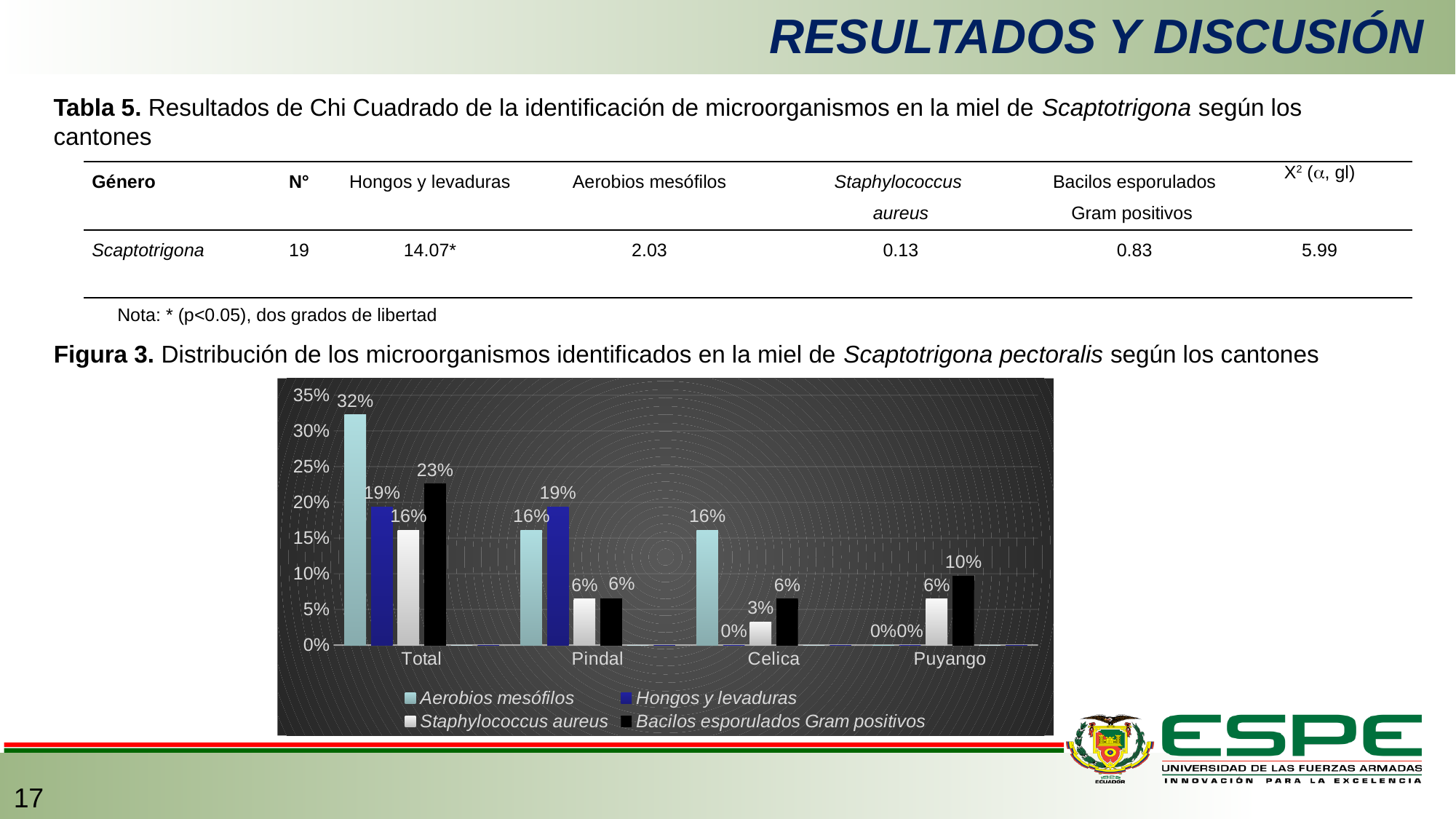
In Figura 3, which series has the highest value in the Total category? Aerobios mesófilos In Figura 3, what is the value for Hongos y levaduras in Pindal? 19% In Figura 3, which series has the lowest value in Celica? Hongos y levaduras In Figura 3, what is the value for Aerobios mesófilos in the Total category? 32% In Figura 3, how many cantón categories are shown on the x axis? 4 In Figura 3, which is larger in Pindal: Aerobios mesófilos or Hongos y levaduras? Hongos y levaduras In Figura 3, what is the value for Bacilos esporulados Gram positivos in Puyango? 10% In Figura 3, how many series does the legend list? 4 In Figura 3, what is the value for Staphylococcus aureus in Celica? 3% In Figura 3, what colour are the bars for Bacilos esporulados Gram positivos? Black What type of chart is Figura 3? Bar chart In Figura 3, what is the difference between Aerobios mesófilos and Bacilos esporulados Gram positivos in the Total category? 9%